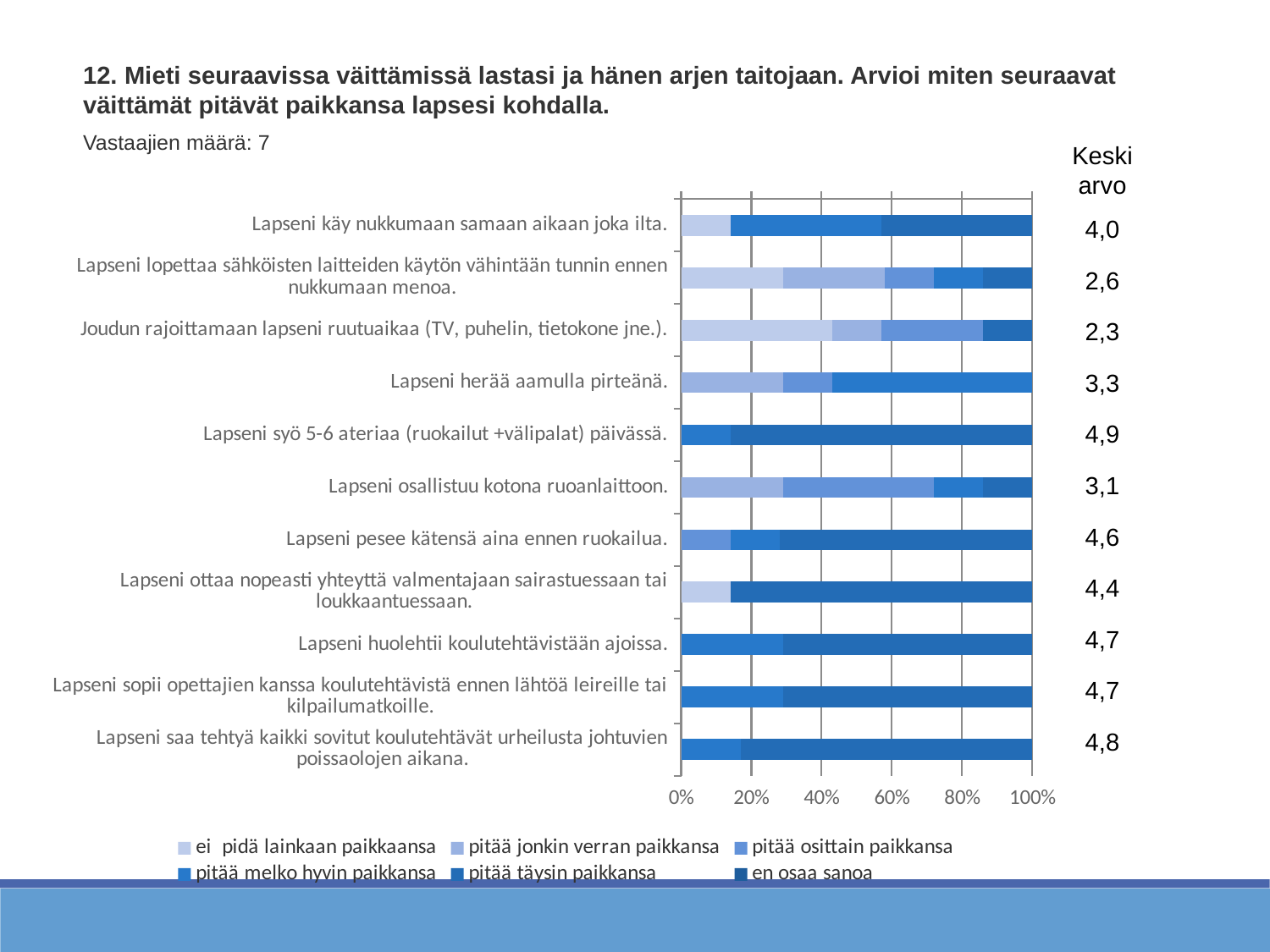
How many statements (categories) are plotted in the chart? 11 Which statement has the lowest Keskiarvo? Joudun rajoittamaan lapseni ruutuaikaa (TV, puhelin, tietokone jne.). How many series does the legend list? 6 Which statement has the highest Keskiarvo? Lapseni syö 5-6 ateriaa (ruokailut +välipalat) päivässä. What is the Keskiarvo (mean) for 'Lapseni käy nukkumaan samaan aikaan joka ilta.'? 4,0 What kind of chart is shown on the slide? Stacked bar chart What is the difference between the highest Keskiarvo (4,9) and the lowest Keskiarvo (2,3)? 2,6 What is the Keskiarvo for 'Lapseni herää aamulla pirteänä.'? 3,3 How many respondents (Vastaajien määrä) does the slide report? 7 What is the Keskiarvo for 'Lapseni osallistuu kotona ruoanlaittoon.'? 3,1 Which has a higher Keskiarvo: 'Lapseni pesee kätensä aina ennen ruokailua.' or 'Lapseni ottaa nopeasti yhteyttä valmentajaan sairastuessaan tai loukkaantuessaan.'? Lapseni pesee kätensä aina ennen ruokailua. Is the 'pitää täysin paikkansa' share for 'Lapseni syö 5-6 ateriaa (ruokailut +välipalat) päivässä.' greater or less than 80%? greater